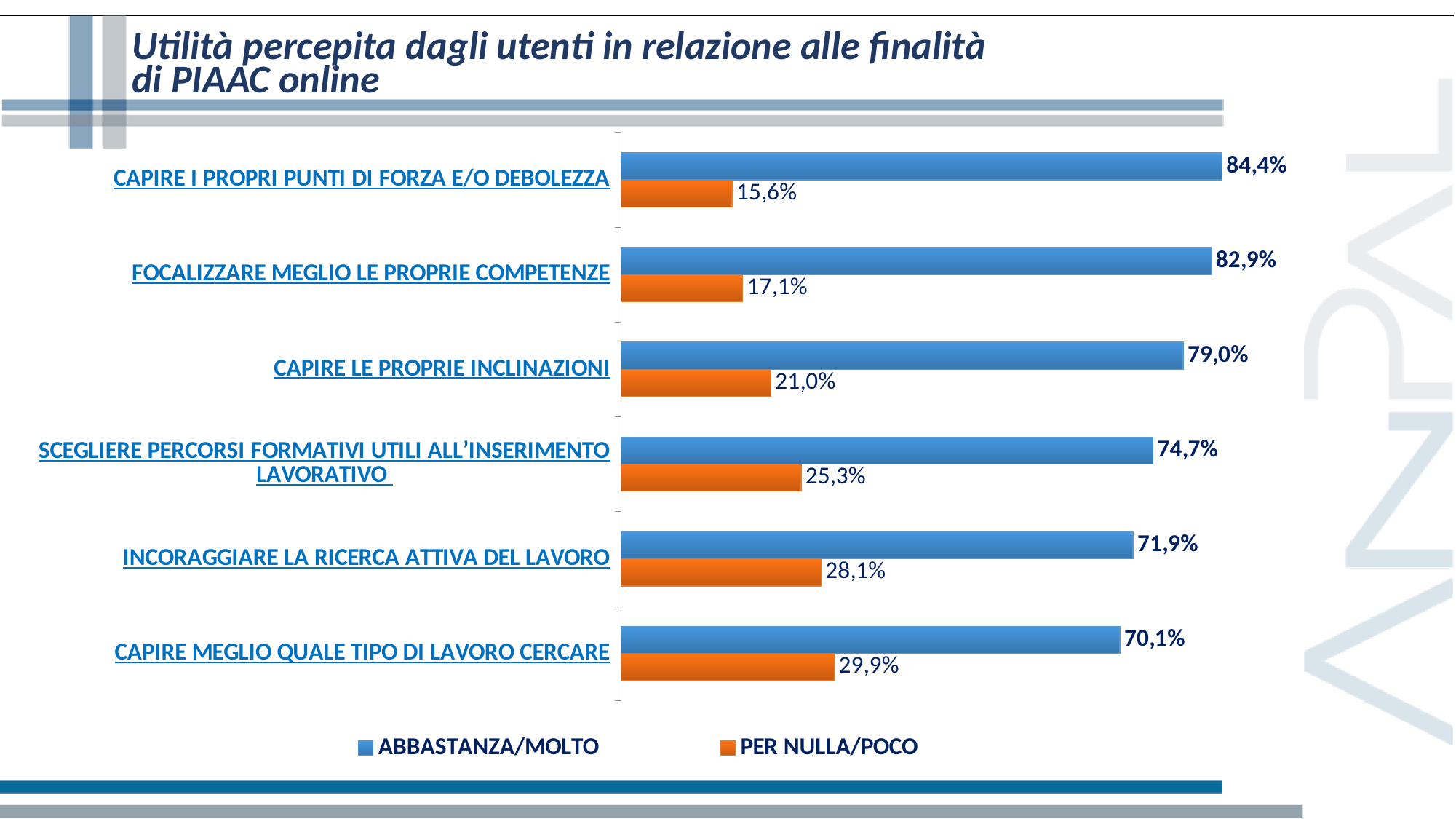
How many categories are shown in the chart? 6 Which category has the lowest PER NULLA/POCO value? CAPIRE I PROPRI PUNTI DI FORZA E/O DEBOLEZZA What is the difference between the ABBASTANZA/MOLTO and PER NULLA/POCO values for INCORAGGIARE LA RICERCA ATTIVA DEL LAVORO? 43,8% How many series does the legend list? 2 Which colour represents the PER NULLA/POCO series? Orange What is the ABBASTANZA/MOLTO value for CAPIRE I PROPRI PUNTI DI FORZA E/O DEBOLEZZA? 84,4% Which is larger: the ABBASTANZA/MOLTO value for FOCALIZZARE MEGLIO LE PROPRIE COMPETENZE or for SCEGLIERE PERCORSI FORMATIVI UTILI ALL'INSERIMENTO LAVORATIVO? FOCALIZZARE MEGLIO LE PROPRIE COMPETENZE Which category has the lowest ABBASTANZA/MOLTO value? CAPIRE MEGLIO QUALE TIPO DI LAVORO CERCARE What is the PER NULLA/POCO value for CAPIRE MEGLIO QUALE TIPO DI LAVORO CERCARE? 29,9% What is the PER NULLA/POCO value for CAPIRE LE PROPRIE INCLINAZIONI? 21,0% Which category has the highest ABBASTANZA/MOLTO value? CAPIRE I PROPRI PUNTI DI FORZA E/O DEBOLEZZA What kind of chart is shown on the slide? Bar chart